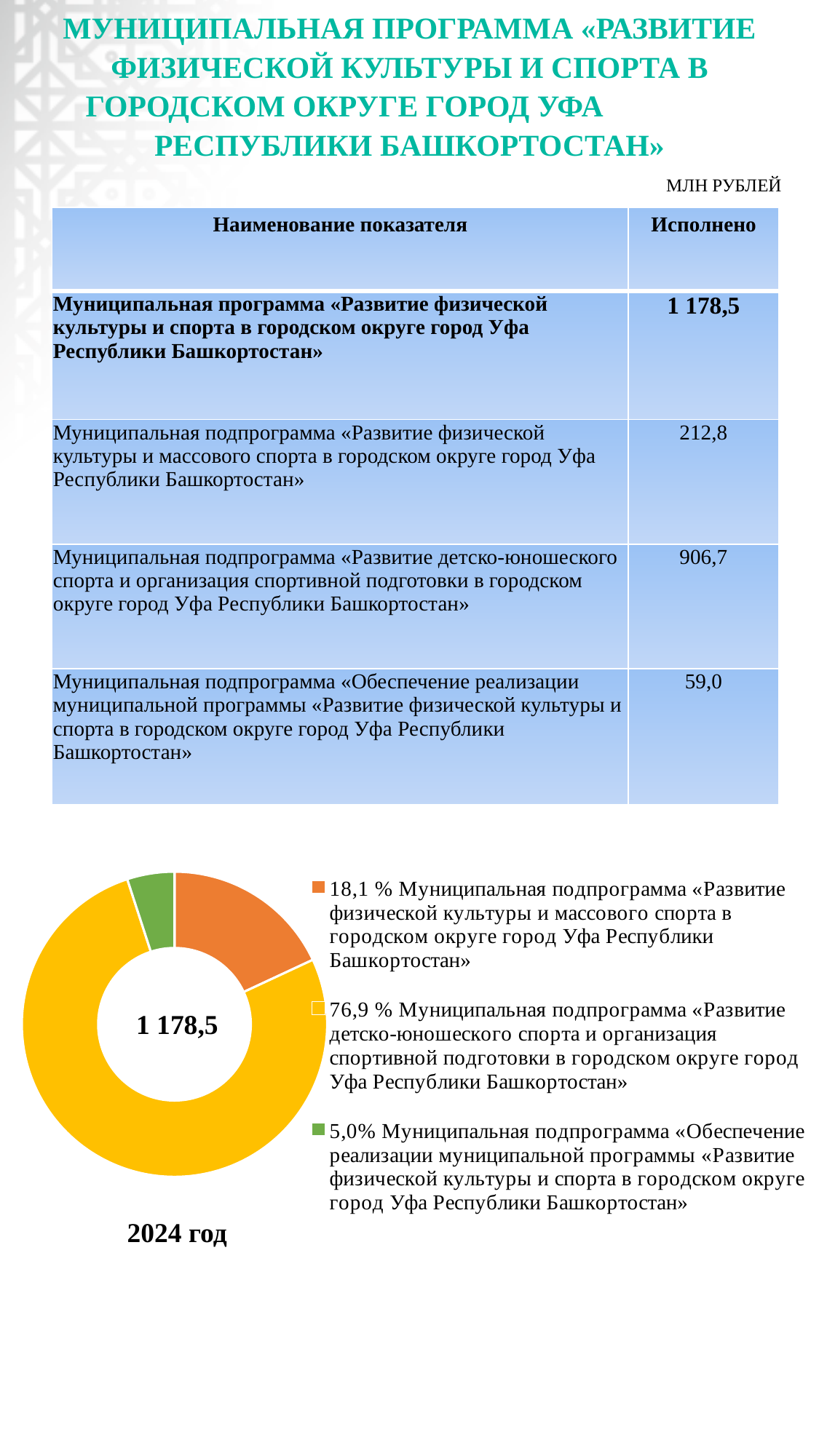
What year is labelled beneath the doughnut chart? 2024 год Which subprogram has the largest slice in the doughnut chart? «Развитие детско-юношеского спорта и организация спортивной подготовки в городском округе город Уфа Республики Башкортостан» What colour is the slice for the subprogram «Развитие детско-юношеского спорта и организация спортивной подготовки» in the doughnut chart? Yellow Which subprogram has the smallest slice in the doughnut chart? «Обеспечение реализации муниципальной программы «Развитие физической культуры и спорта в городском округе город Уфа Республики Башкортостан» In the doughnut chart, which is larger: the share for «Развитие физической культуры и массового спорта» or the share for «Обеспечение реализации муниципальной программы»? «Развитие физической культуры и массового спорта» What share of the doughnut chart is the subprogram «Развитие физической культуры и массового спорта в городском округе город Уфа Республики Башкортостан»? 18,1 % What value is printed in the centre of the doughnut chart? 1 178,5 How many entries does the legend of the doughnut chart list? 3 What share of the doughnut chart is the subprogram «Обеспечение реализации муниципальной программы «Развитие физической культуры и спорта в городском округе город Уфа Республики Башкортостан»? 5,0% What share of the doughnut chart is the subprogram «Развитие детско-юношеского спорта и организация спортивной подготовки в городском округе город Уфа Республики Башкортостан»? 76,9 % What kind of chart is shown at the bottom of the slide? Doughnut (pie) chart How many slices does the doughnut chart have? 3